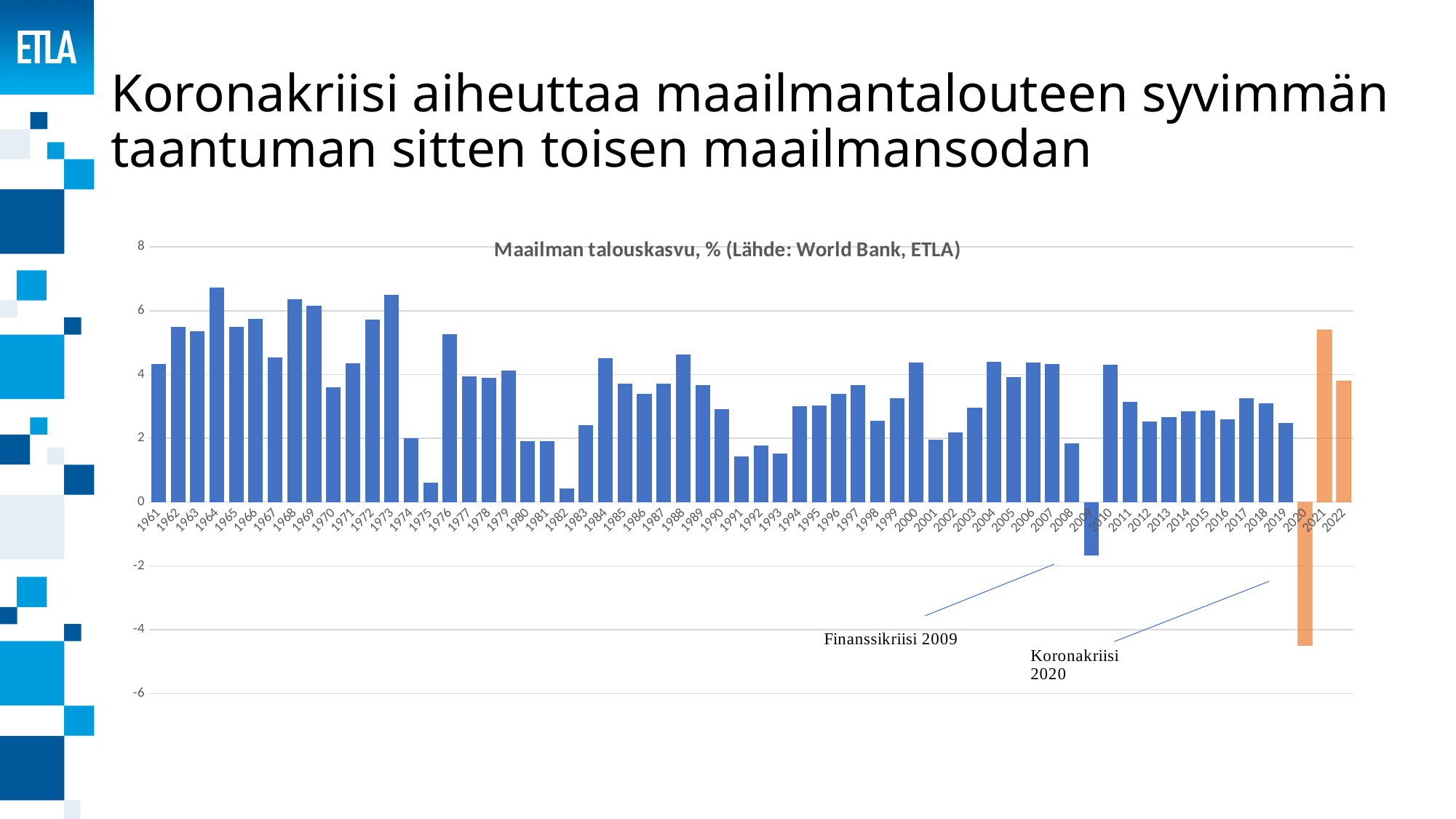
Is the value for 1975 greater or less than 2? less What kind of chart is shown on the slide? bar chart Is the value for 2021 greater or less than 4? greater Which is lower, the value for 2009 or the value for 2020? 2020 Do the values rise or fall from 2020 to 2021? rise How many years (bars) are plotted in the chart? 62 What is the title of the chart? Maailman talouskasvu, % (Lähde: World Bank, ETLA) Is the value for 2009 greater or less than -2? greater Which years are shown with orange bars instead of blue? 2020, 2021 and 2022 Which year has the lowest value in the chart? 2020 Which is higher, the value for 1964 or the value for 1975? 1964